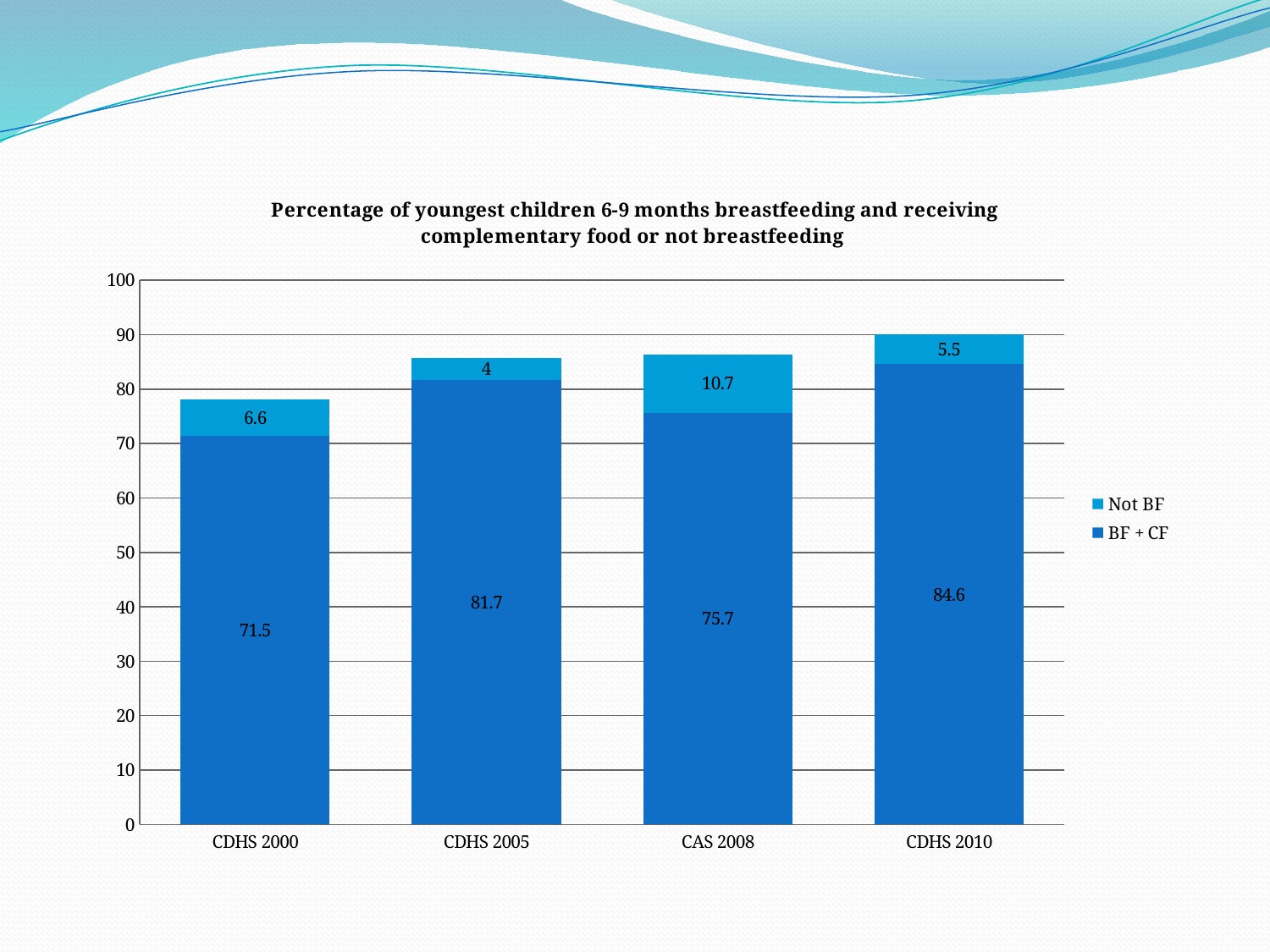
What is the total of the stacked bar for CDHS 2000? 78.1 How many surveys are shown on the x axis? 4 What is the Not BF value for CDHS 2010? 5.5 What is the Not BF value for CAS 2008? 10.7 What kind of chart is shown on the slide? Stacked bar chart Which survey has the highest BF + CF value? CDHS 2010 Which survey has the lowest Not BF value? CDHS 2005 What is the BF + CF value for CDHS 2005? 81.7 Which is larger, the Not BF value for CDHS 2000 or for CAS 2008? CAS 2008 What is the total of the stacked bar for CDHS 2010? 90.1 What is the difference between the BF + CF values for CDHS 2010 and CDHS 2000? 13.1 How many series does the legend list? 2